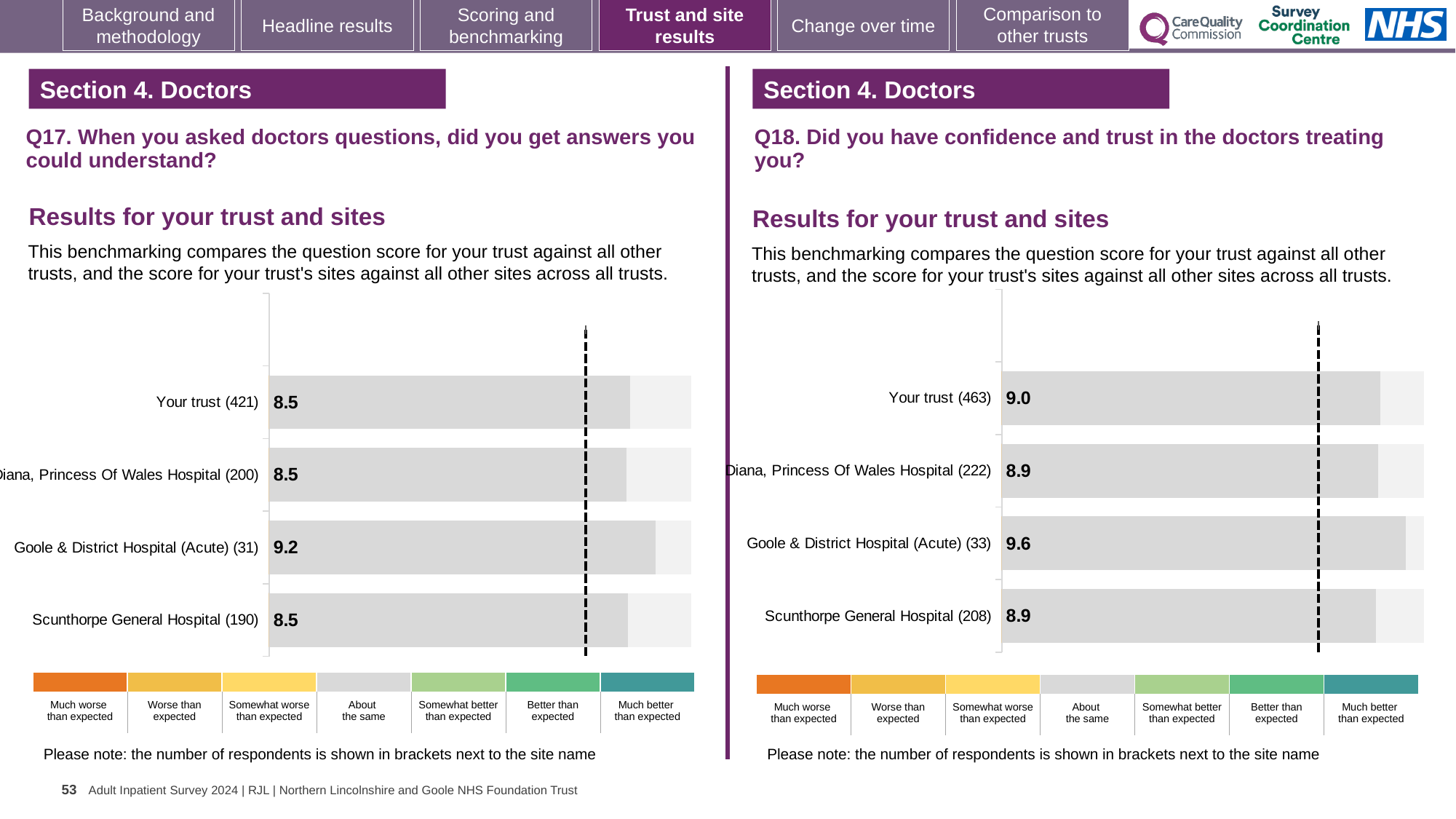
On the Q17 chart (left), how many bars are plotted? 4 On the Q17 chart (left), what is the difference between the score for Goole & District Hospital (Acute) and the score for Scunthorpe General Hospital? 0.7 On the Q17 chart (left), which site has the highest score? Goole & District Hospital (Acute) On the Q18 chart (right), what is the score for Scunthorpe General Hospital? 8.9 On the Q18 chart (right), which site has the highest score? Goole & District Hospital (Acute) On the Q18 chart (right), which is larger: the score for Your trust or the score for Diana, Princess Of Wales Hospital? Your trust On the Q17 chart (left), what is the score for Your trust? 8.5 On the Q17 chart (left), how many respondents are shown in brackets for Your trust? 421 On the Q17 chart (left), what is the score for Goole & District Hospital (Acute)? 9.2 What kind of chart is used on the Q18 chart (right)? Bar chart On the Q18 chart (right), what is the score for Your trust? 9.0 On the Q18 chart (right), what is the difference between the score for Goole & District Hospital (Acute) and the score for Your trust? 0.6